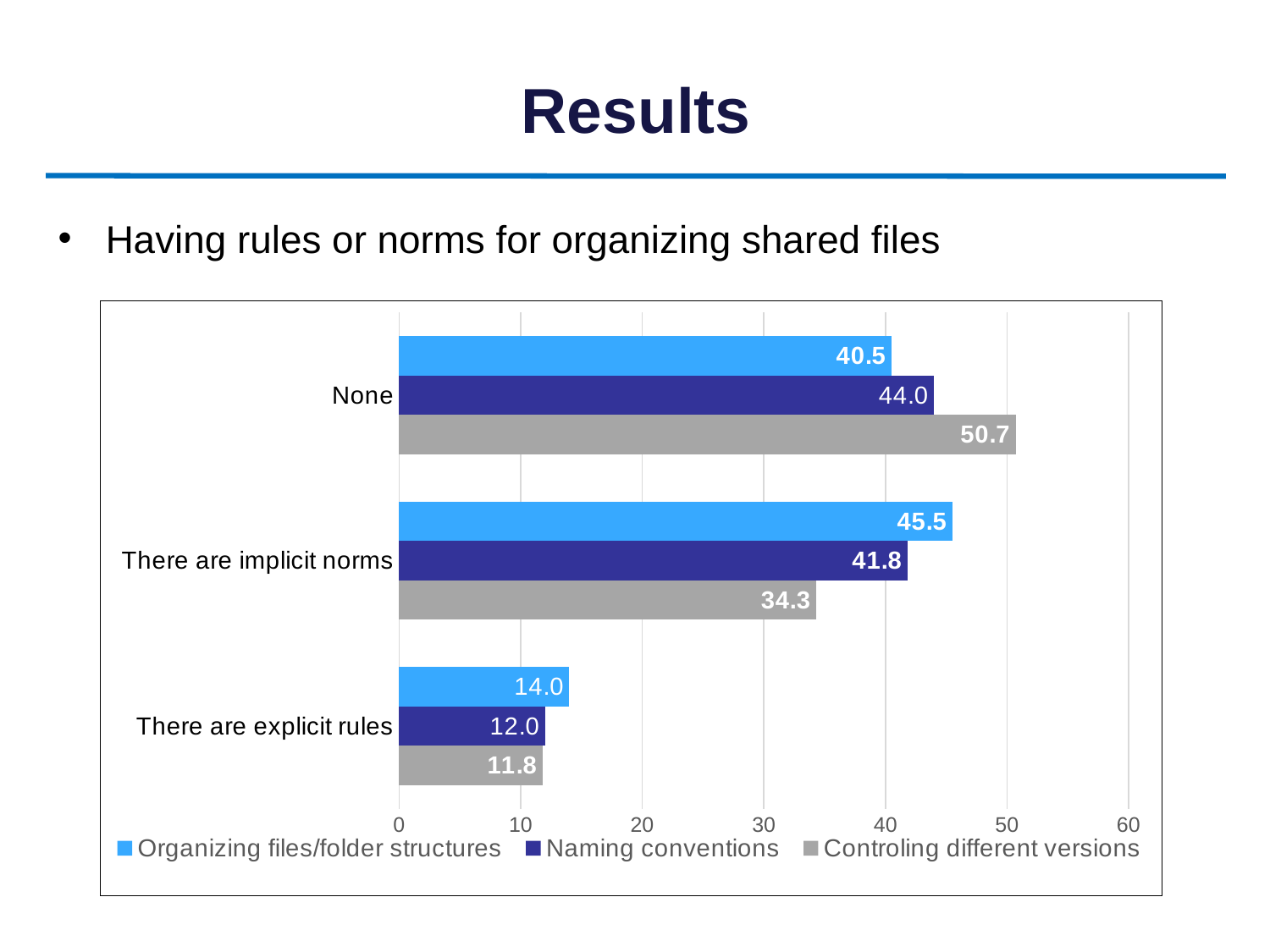
What is the value for Organizing files/folder structures in the There are explicit rules category? 14.0 What kind of chart is shown on the slide? Bar chart What is the value for Naming conventions in the None category? 44.0 Which series is shown in grey in the legend? Controling different versions What is the value for Controling different versions in the There are implicit norms category? 34.3 How many series does the legend list? 3 Is the value for Controling different versions in the None category greater or less than 50? greater Which is larger in the There are implicit norms category: Organizing files/folder structures or Naming conventions? Organizing files/folder structures How many categories are shown on the chart? 3 What is the difference between the Controling different versions value and the Organizing files/folder structures value in the None category? 10.2 Which category has the highest value for Controling different versions? None Which category has the lowest value for Naming conventions? There are explicit rules